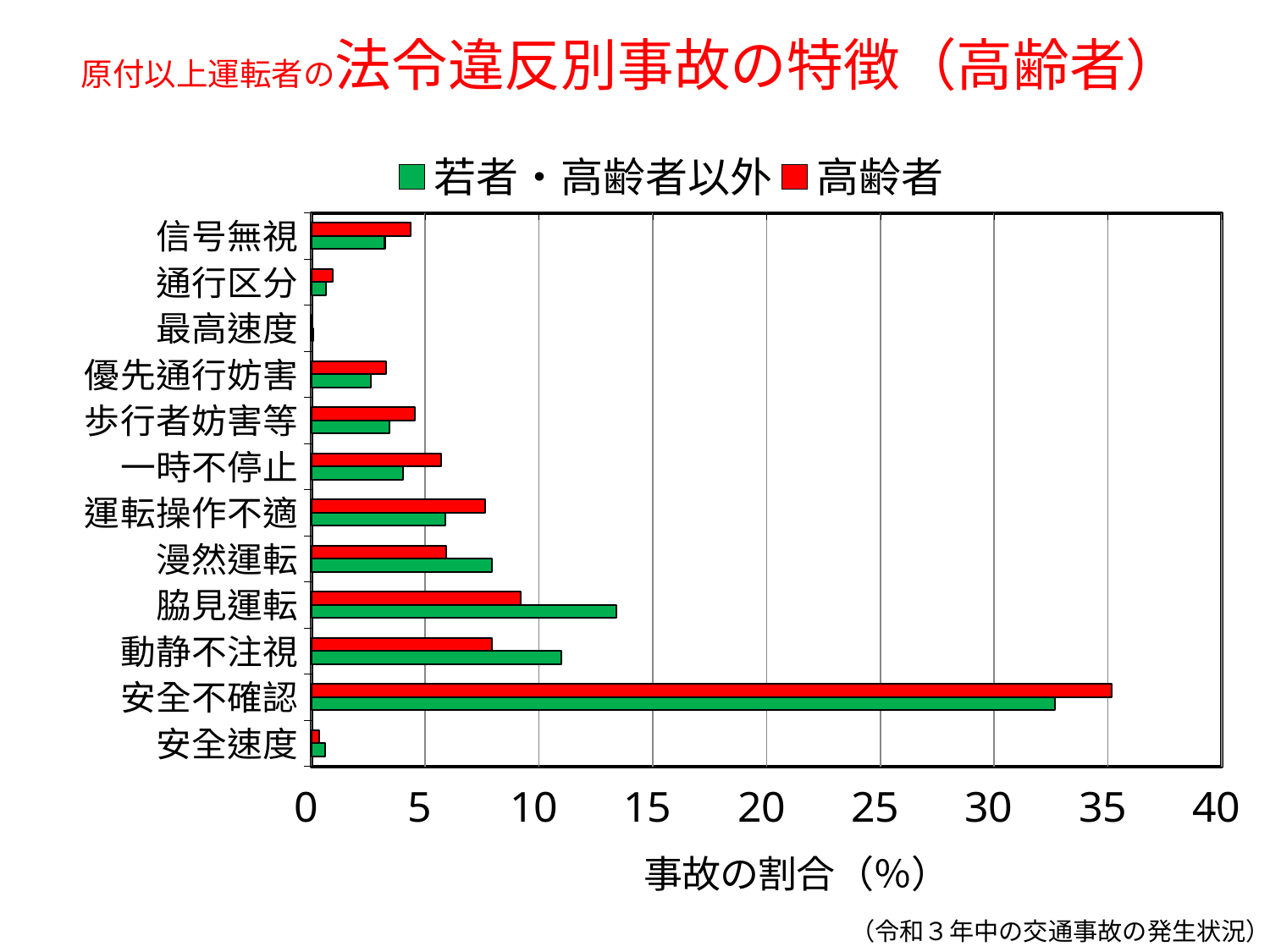
For 運転操作不適, which series has the larger value, 若者・高齢者以外 or 高齢者? 高齢者 Is the 高齢者 value for 安全不確認 greater or less than 30? greater Which category has the highest value for the 高齢者 series? 安全不確認 How many series does the legend list? 2 Is the 高齢者 value for 脇見運転 greater or less than 10? less How many violation categories are plotted on the y axis? 12 Is the 若者・高齢者以外 value for 脇見運転 greater or less than 10? greater Which category has the highest value for the 若者・高齢者以外 series? 安全不確認 For 脇見運転, which series has the larger value, 若者・高齢者以外 or 高齢者? 若者・高齢者以外 What kind of chart is shown on the slide? bar chart Which colour represents the 高齢者 series in the legend? red